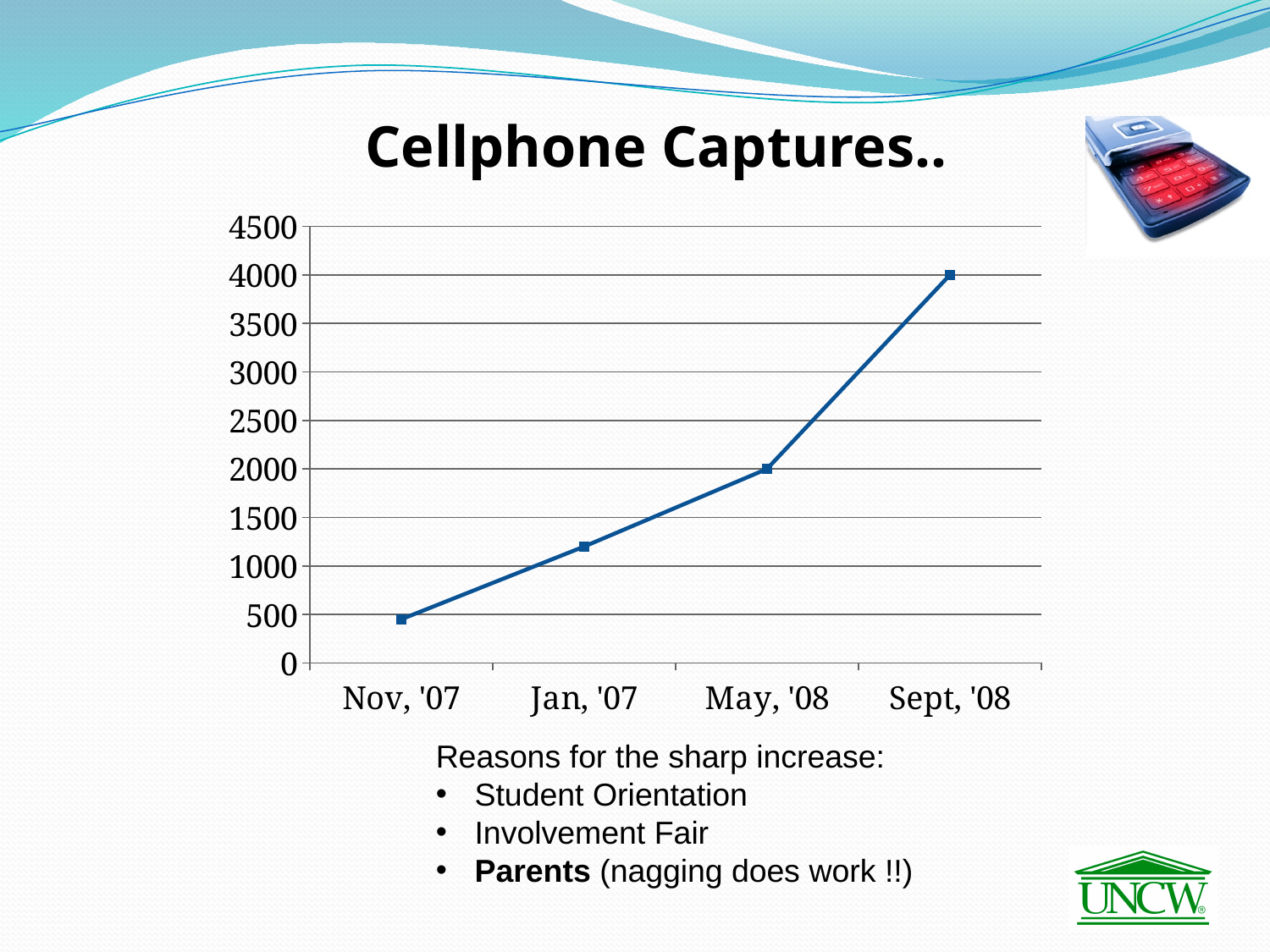
What is the value for May, '08? 2000 Do the values rise or fall from Nov, '07 to Sept, '08? rise What is the title of the slide containing the chart? Cellphone Captures.. What is the value for Sept, '08? 4000 Is the value for Jan, '07 greater or less than 1000? greater Which date has the highest value on the chart? Sept, '08 Which date has the lowest value on the chart? Nov, '07 How many data points are plotted on the line chart? 4 Which is larger, the value for Jan, '07 or the value for May, '08? May, '08 What kind of chart is shown on the slide? line chart What is the difference between the values for Sept, '08 and May, '08? 2000